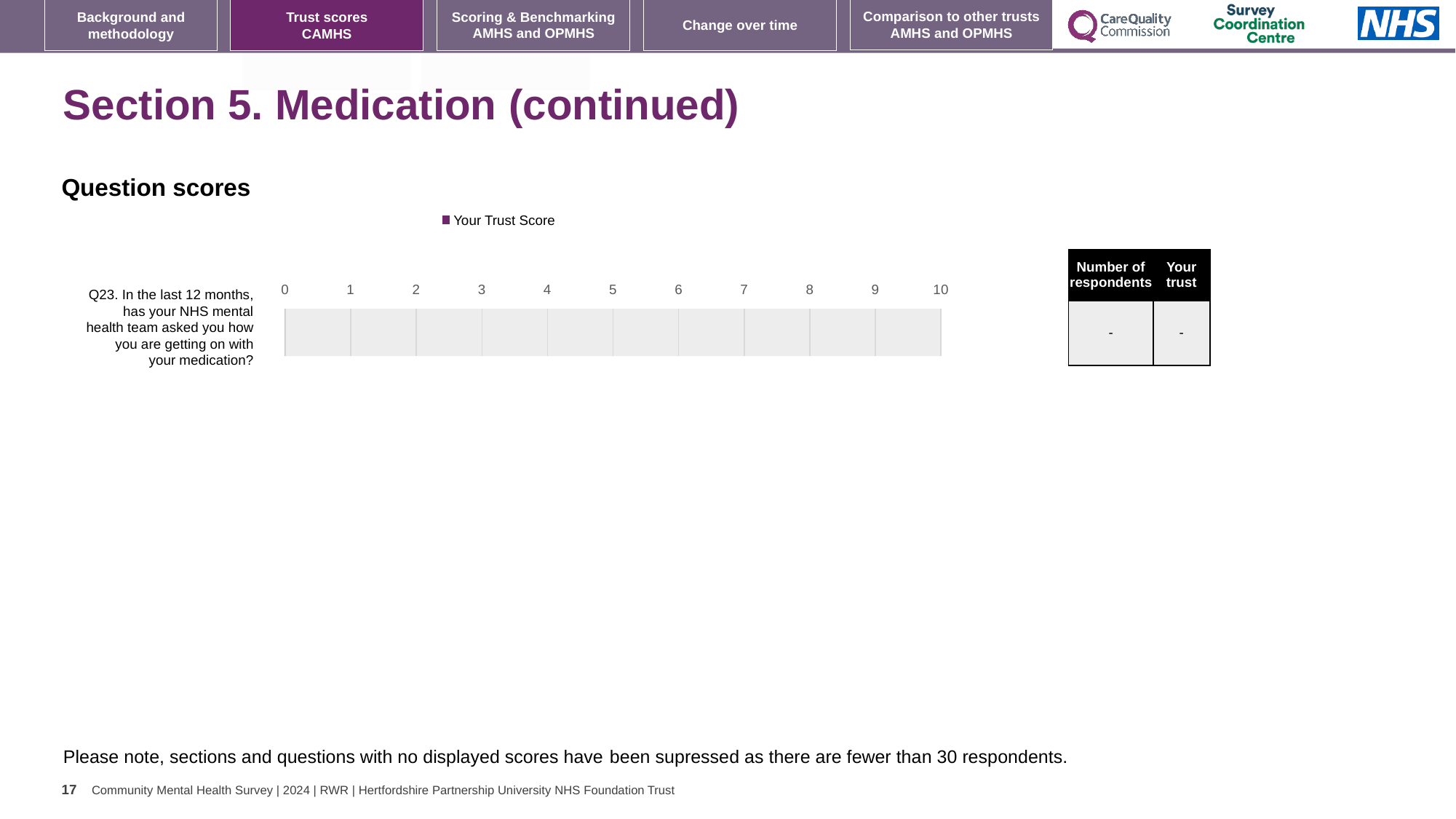
Which question is listed as the category on the chart? Q23. In the last 12 months, has your NHS mental health team asked you how you are getting on with your medication? What kind of chart is shown under 'Question scores'? bar chart How many question categories are shown on the chart? 1 What value is shown for 'Your trust' in the table next to the chart? - How many series does the chart legend list? 1 Is a bar plotted for Q23 on the chart? No What is the name of the series in the chart legend? Your Trust Score What value is shown for 'Number of respondents' in the table next to the chart? - What is the highest value shown on the chart's axis? 10